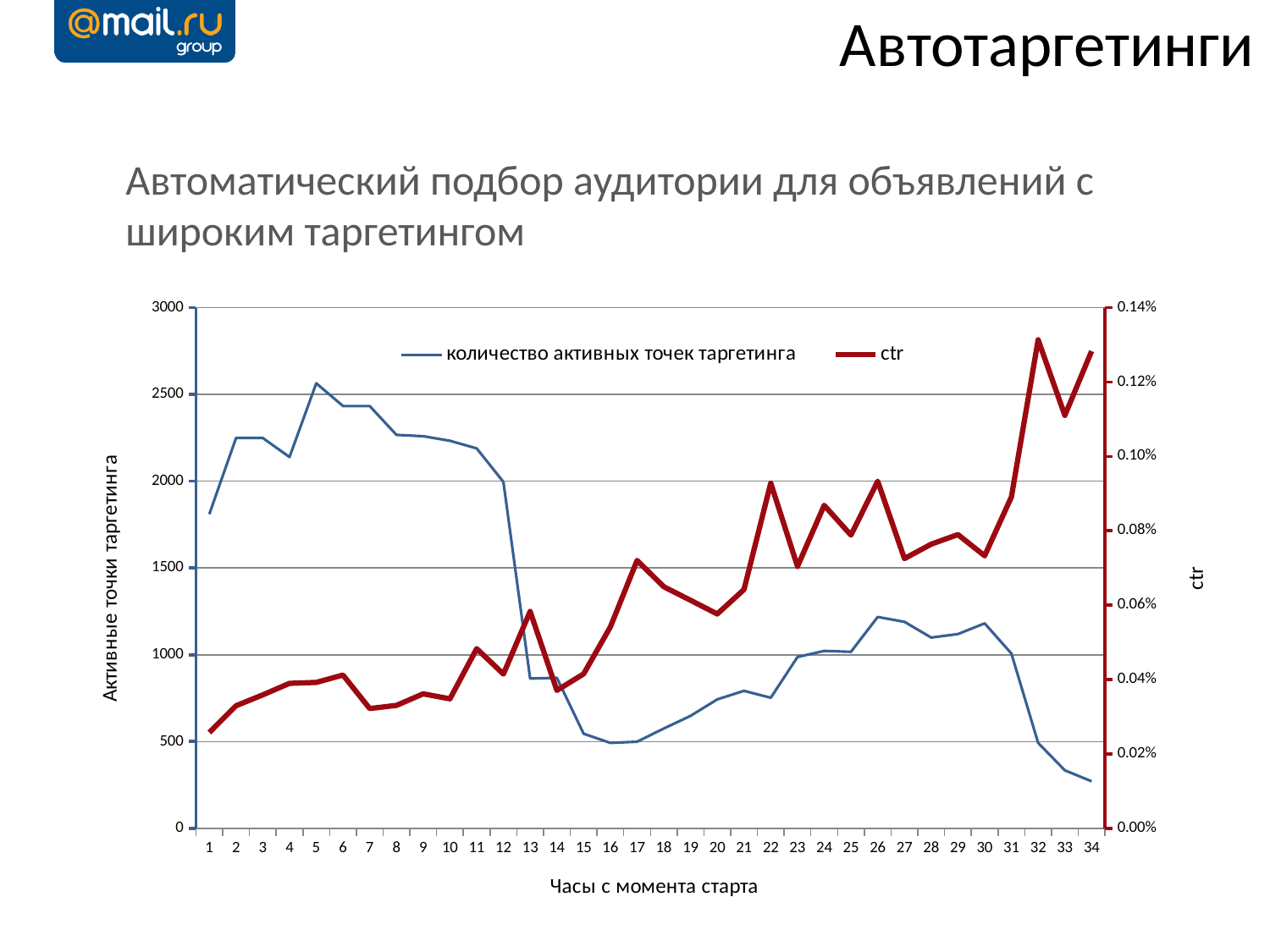
What kind of chart is shown on the slide? line chart Is the value of 'ctr' at hour 22 greater or less than 0.08%? greater How many hours (points) are shown along the x axis of the chart? 34 Is the value of 'количество активных точек таргетинга' at hour 5 greater or less than 2500? greater At which hour is the 'ctr' series at its lowest value? 1 Does the series 'количество активных точек таргетинга' rise or fall between hour 12 and hour 16? fall Which is larger for 'количество активных точек таргетинга': the value at hour 5 or the value at hour 20? hour 5 At which hour does the series 'количество активных точек таргетинга' reach its highest value? 5 How many series does the chart legend list? 2 At which hour does the series 'количество активных точек таргетинга' reach its lowest value? 34 Is the value of 'ctr' at hour 32 greater or less than 0.12%? greater What is the title of the x axis of the chart? Часы с момента старта